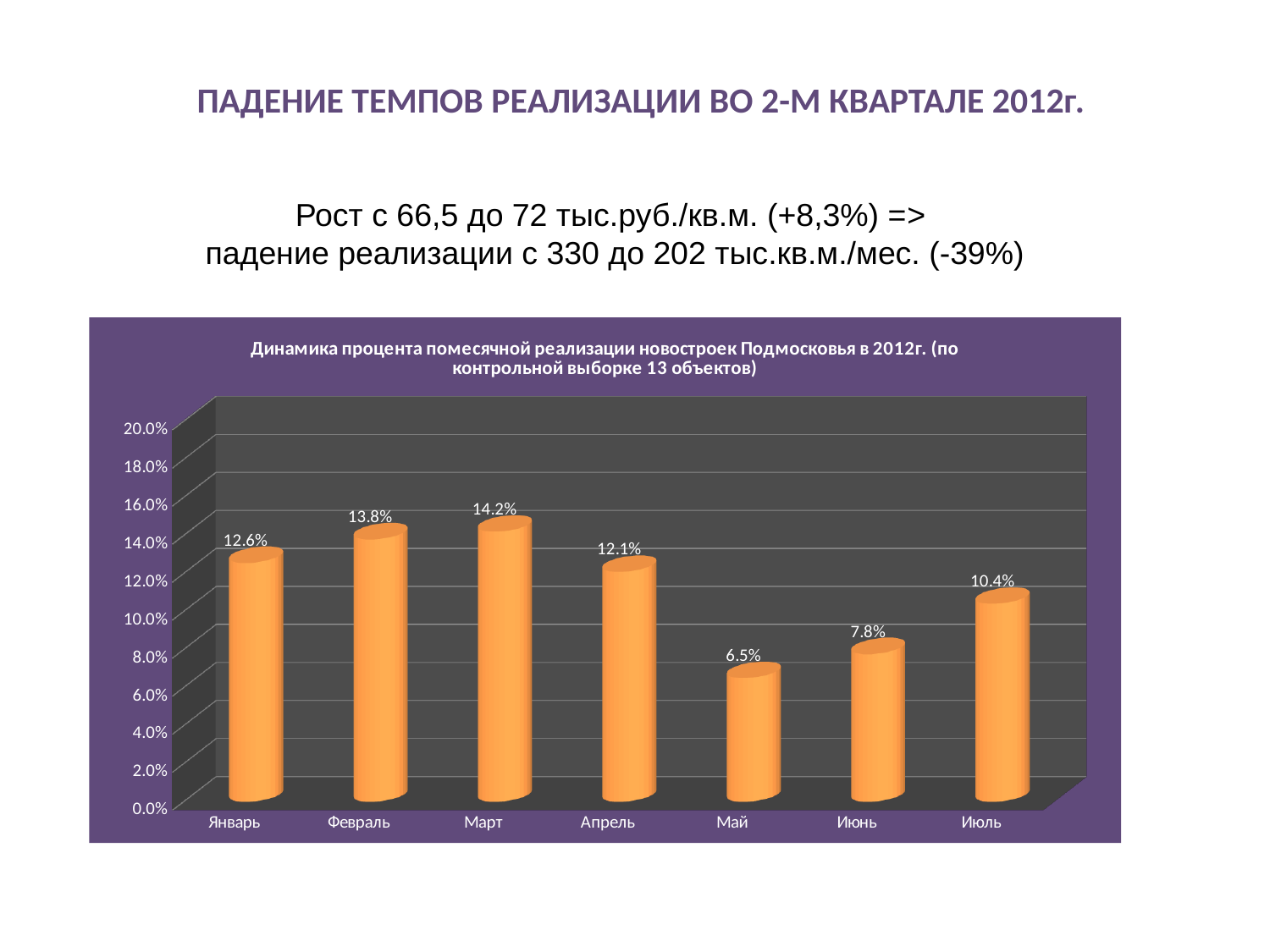
What is the difference between the values for Январь and Февраль? 1.2% Do the values rise or fall from Март to Май? fall What kind of chart is shown on the slide? bar chart Which month has the lowest value? Май Which is larger, the value for Февраль or the value for Апрель? Февраль What is the value for Июль? 10.4% What is the value for Май? 6.5% What is the difference between the values for Март and Май? 7.7% Is the value for Июнь greater or less than 10.0%? less Which month has the highest value? Март What is the value for Март? 14.2% How many months are shown on the x axis? 7